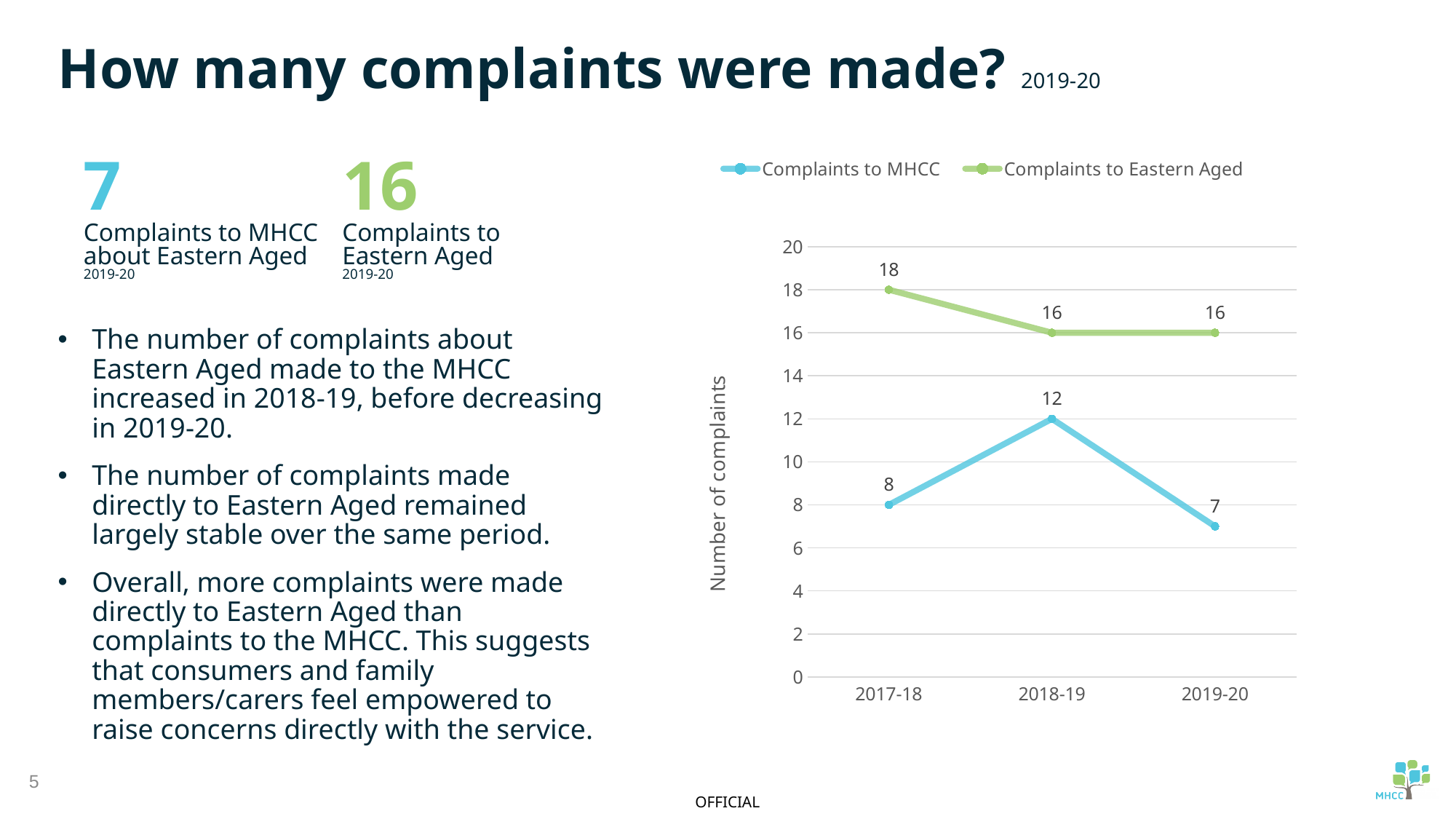
What is the value for Complaints to MHCC in 2019-20? 7 What is the label of the chart's vertical axis? Number of complaints In which year was the number of Complaints to MHCC lowest? 2019-20 What type of chart is shown on the slide? Line chart Do the values for Complaints to Eastern Aged rise or fall from 2017-18 to 2018-19? Fall What is the value for Complaints to MHCC in 2018-19? 12 Which series has the larger value in 2018-19, Complaints to MHCC or Complaints to Eastern Aged? Complaints to Eastern Aged How many years are plotted on the x axis of the chart? 3 What is the difference between Complaints to Eastern Aged and Complaints to MHCC in 2017-18? 10 In which year was the number of Complaints to MHCC highest? 2018-19 What is the value for Complaints to Eastern Aged in 2017-18? 18 How many series does the chart legend list? 2